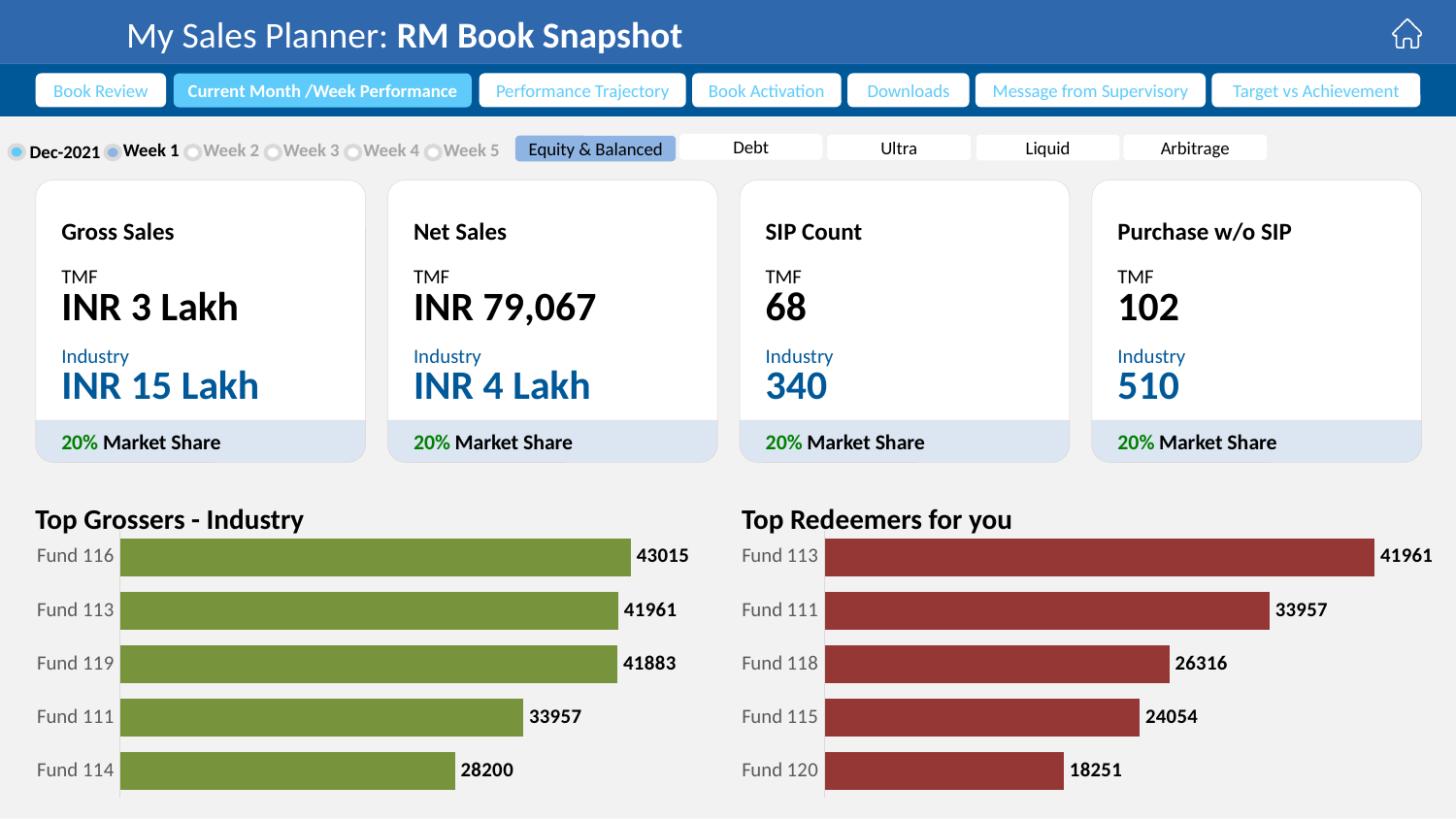
In the 'Top Grossers - Industry' chart, what is the difference between the values for Fund 116 and Fund 114? 14815 In the 'Top Redeemers for you' chart, what is the value for Fund 118? 26316 What type of chart is the 'Top Redeemers for you' chart? Bar chart In the 'Top Grossers - Industry' chart, which fund has the lowest value? Fund 114 How many funds are shown in the 'Top Redeemers for you' chart? 5 In the 'Top Grossers - Industry' chart, what is the value for Fund 111? 33957 How many funds are shown in the 'Top Grossers - Industry' chart? 5 In the 'Top Redeemers for you' chart, which fund has the highest value? Fund 113 In the 'Top Redeemers for you' chart, what is the difference between the values for Fund 113 and Fund 111? 8004 What colour are the bars in the 'Top Grossers - Industry' chart? Green In the 'Top Grossers - Industry' chart, what is the value for Fund 116? 43015 In the 'Top Redeemers for you' chart, which is larger: the value for Fund 115 or the value for Fund 120? Fund 115